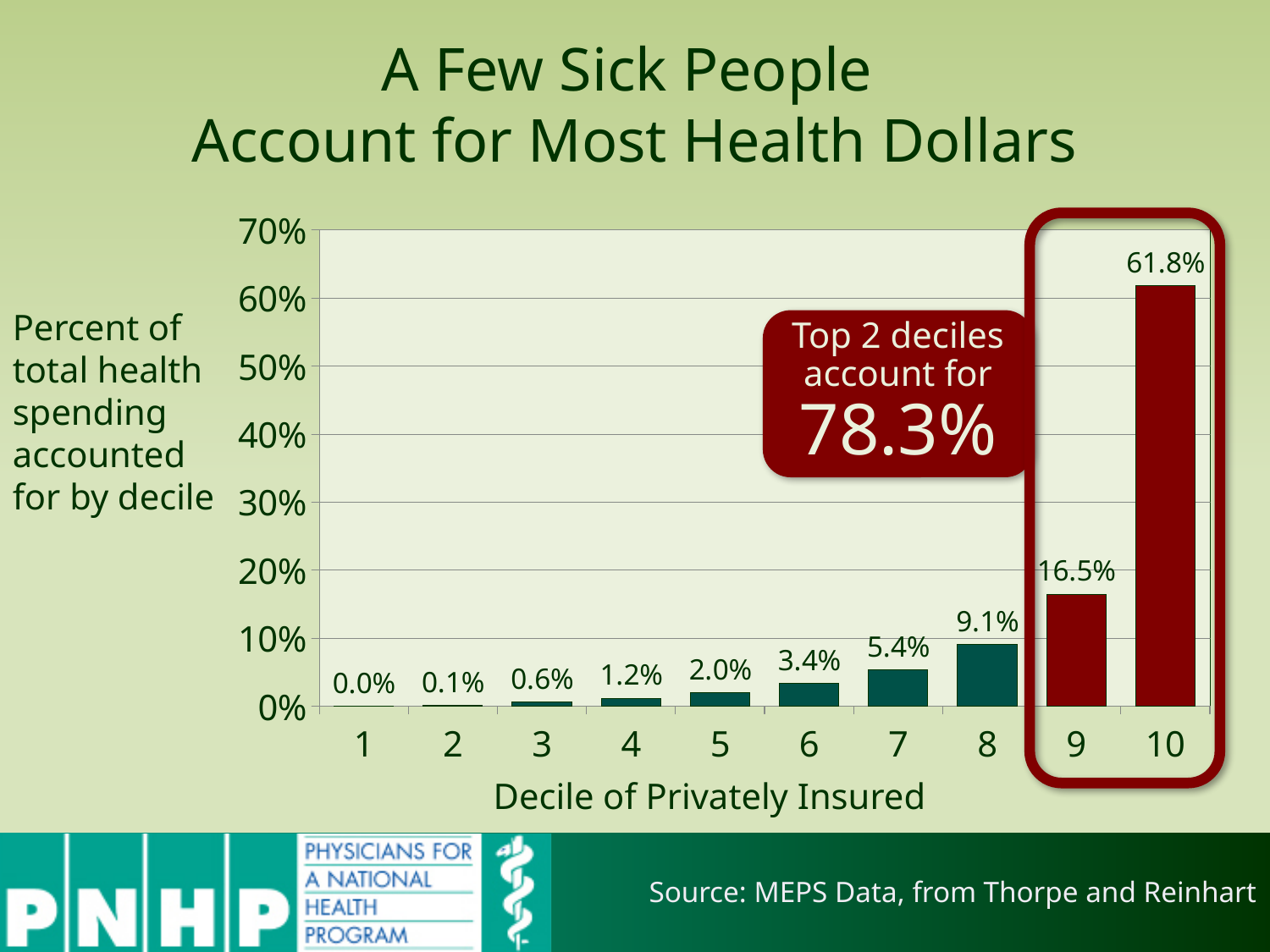
What percent of total health spending is accounted for by decile 9? 16.5% How many deciles are shown on the x axis? 10 What is the difference between the values for decile 8 and decile 7? 3.7% Do the values rise or fall as the decile number increases from 1 to 10? Rise Which has a larger value, decile 5 or decile 7? Decile 7 What is the difference between the values for decile 10 and decile 9? 45.3% What is the value shown for decile 6? 3.4% What percent of total health spending is accounted for by decile 10? 61.8% Is the value for decile 10 greater or less than 60%? greater What kind of chart is shown on the slide? Bar chart Which decile accounts for the highest share of total health spending? 10 Which decile accounts for the lowest share of total health spending? 1